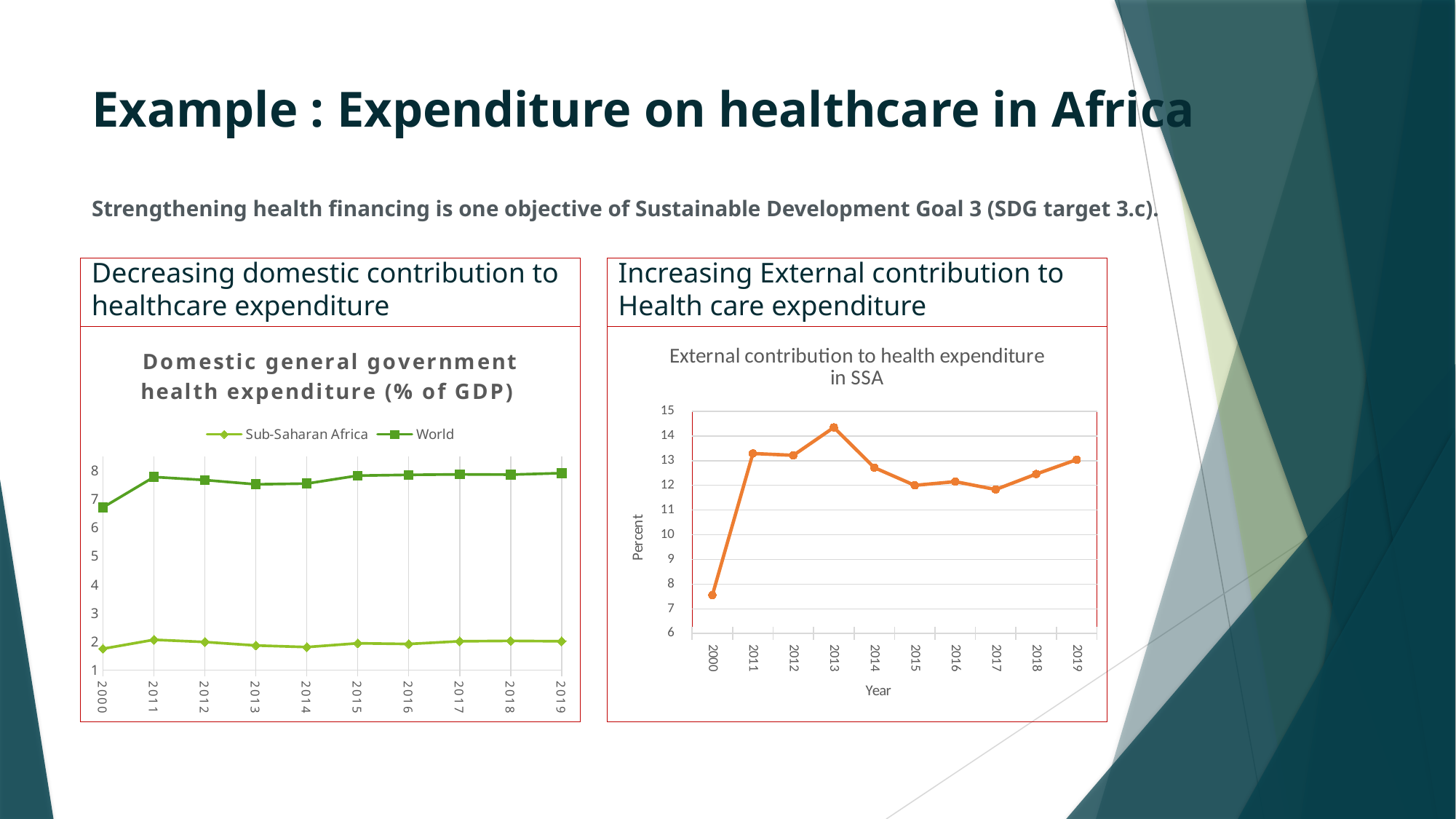
In the chart titled "Domestic general government health expenditure (% of GDP)", what are the two series named in the legend? Sub-Saharan Africa and World In the chart titled "External contribution to health expenditure in SSA", what is the label on the vertical axis? Percent In the chart titled "Domestic general government health expenditure (% of GDP)", what kind of chart is shown? line chart In the chart titled "External contribution to health expenditure in SSA", is the value for 2000 greater or less than 8? less In the chart titled "Domestic general government health expenditure (% of GDP)", how many series does the legend list? 2 In the chart titled "External contribution to health expenditure in SSA", is the value for 2013 greater or less than 14? greater In the chart titled "Domestic general government health expenditure (% of GDP)", which series has higher values in 2015, Sub-Saharan Africa or World? World In the chart titled "External contribution to health expenditure in SSA", which year has the highest value? 2013 In the chart titled "Domestic general government health expenditure (% of GDP)", is the World value for 2000 greater or less than 7? less In the chart titled "External contribution to health expenditure in SSA", which year has the lowest value? 2000 In the chart titled "Domestic general government health expenditure (% of GDP)", how many years are shown on the x axis? 10